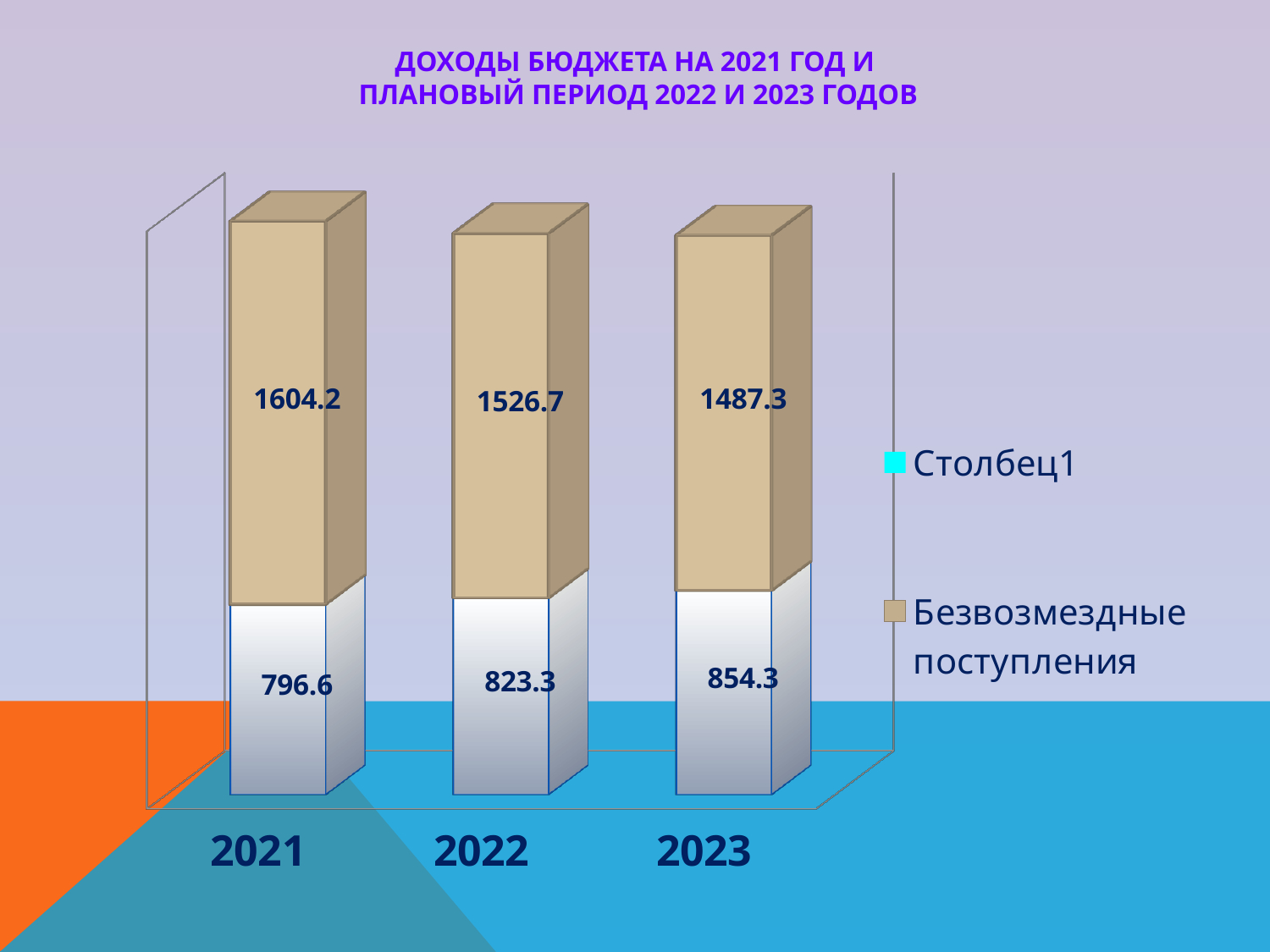
Which year has the highest value for Безвозмездные поступления? 2021 Which year has the lowest value for the lower segment of the bar? 2021 What is the value of Безвозмездные поступления for 2023? 1487.3 What is the value of the lower segment of the 2023 bar? 854.3 How many years are shown on the x axis? 3 What type of chart is shown on the slide? stacked bar chart What is the difference between the Безвозмездные поступления values for 2021 and 2023? 116.9 What is the value of Безвозмездные поступления for 2021? 1604.2 Is the Безвозмездные поступления value larger for 2022 or for 2023? 2022 What is the total of the stacked bar for 2021? 2400.8 What is the value of the lower segment of the 2022 bar? 823.3 How many series does the legend list? 2